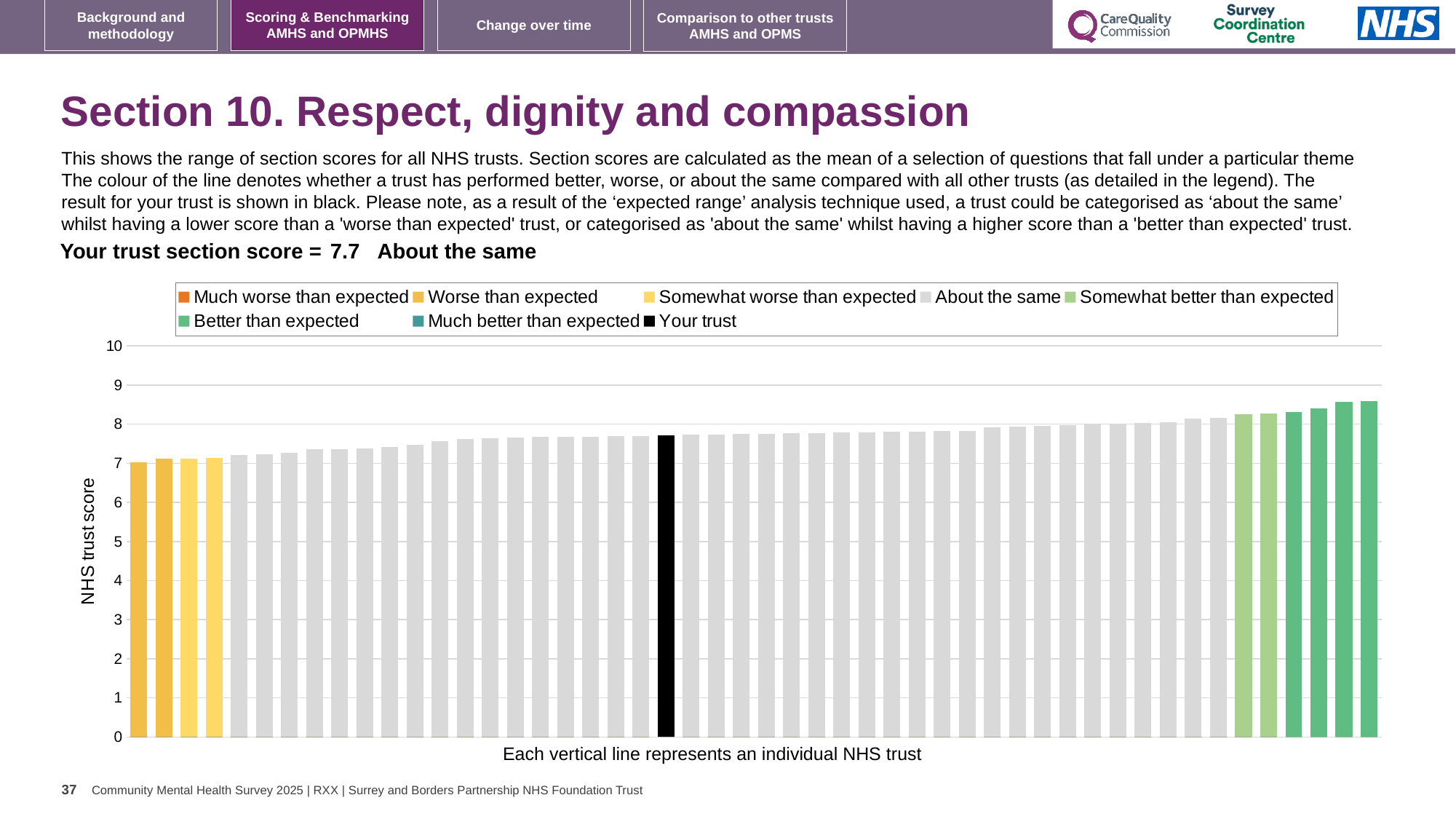
Is the value of the tallest bar greater or less than 8? greater Which is larger: the value for your trust (black bar) or the value of the rightmost bar? the rightmost bar How many bars are coloured as 'Better than expected' (darker green)? 4 What is the section score for your trust shown on the slide? 7.7 What is the label on the y axis of the chart? NHS trust score Which category is your trust placed in for this section? About the same Is the value for your trust (the black bar) greater or less than 7? greater What colour is the bar representing your trust? black What kind of chart is shown on the slide? bar chart How many entries does the chart legend list? 8 Is the value of the shortest bar greater or less than 8? less Do the bar values rise or fall from left to right along the x axis? rise